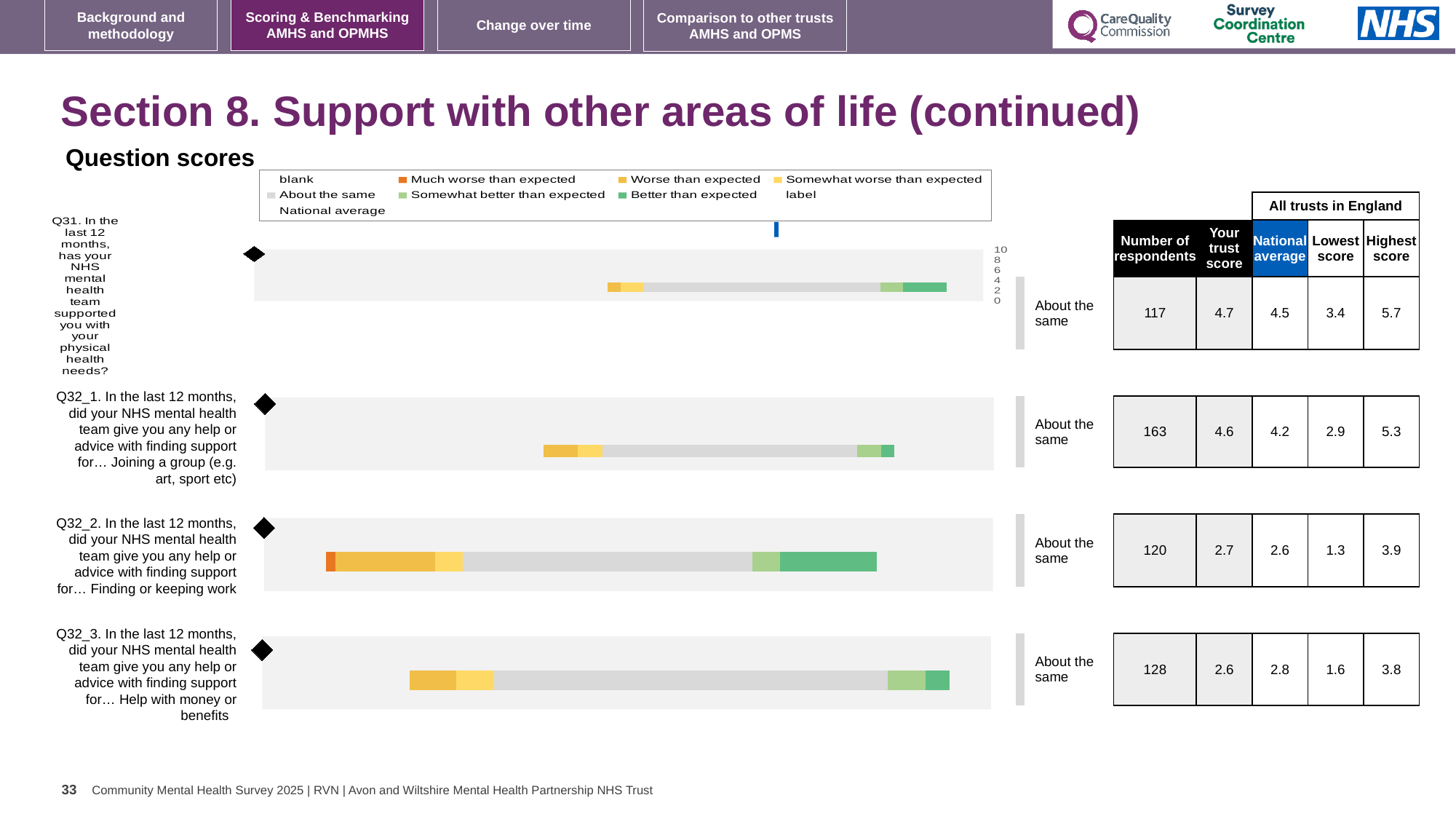
What benchmark category is shown for Q32_2 (finding or keeping work)? About the same What is the highest score among all trusts in England for Q32_3 (help with money or benefits)? 3.8 How many respondents answered Q32_2 (help with finding or keeping work)? 120 What is the national average for Q32_1 (help with joining a group)? 4.2 What is the difference between the trust score and the national average for Q32_1? 0.4 Which question has the lowest trust score on this slide? Q32_3 (help with money or benefits) What is the trust score for Q31 (support with physical health needs)? 4.7 What kind of chart is used to show the question scores on this slide? Bar chart How many entries does the legend above the charts list? 9 Which question has the highest number of respondents? Q32_1 (joining a group) For Q32_3, is the trust score or the national average larger? National average How many questions (Q31, Q32_1, Q32_2, Q32_3) have a benchmark bar on this slide? 4